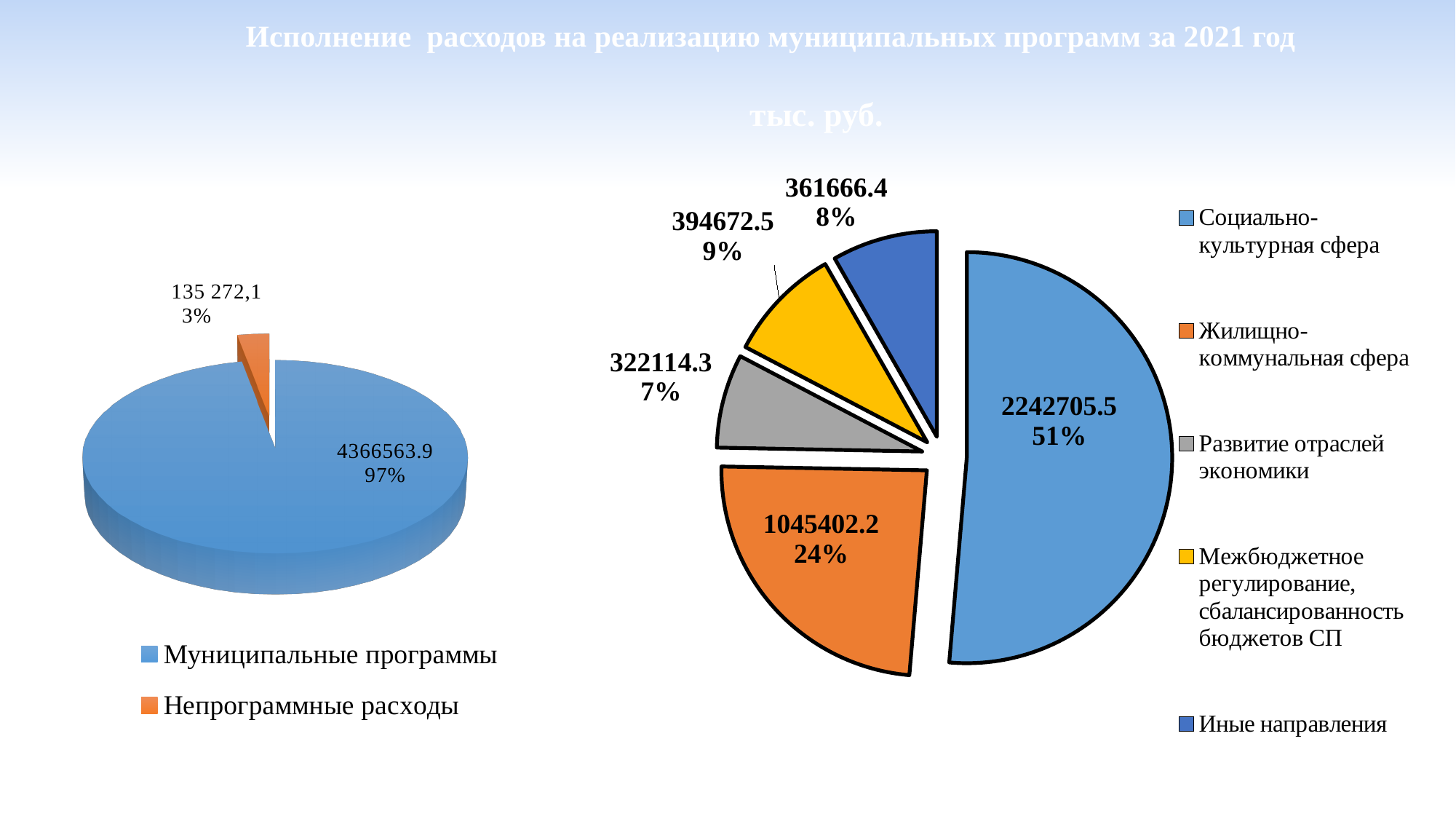
On the right pie chart, what share of the pie does Развитие отраслей экономики take? 7% On the right pie chart, which is larger: Межбюджетное регулирование, сбалансированность бюджетов СП or Иные направления? Межбюджетное регулирование, сбалансированность бюджетов СП How many categories does the right pie chart's legend list? 5 On the right pie chart, what is the value for Социально-культурная сфера? 2242705.5 On the right pie chart, what is the difference between the values for Социально-культурная сфера and Жилищно-коммунальная сфера? 1197303.3 On the left pie chart, what is the value for Непрограммные расходы? 135 272,1 On the right pie chart, which category has the largest slice? Социально-культурная сфера On the right pie chart, what is the value for Жилищно-коммунальная сфера? 1045402.2 On the right pie chart, which category has the smallest slice? Развитие отраслей экономики On the left pie chart, what is the value for Муниципальные программы? 4366563.9 What type of chart is the left chart? Pie chart On the left pie chart, what share of the pie does Непрограммные расходы take? 3%